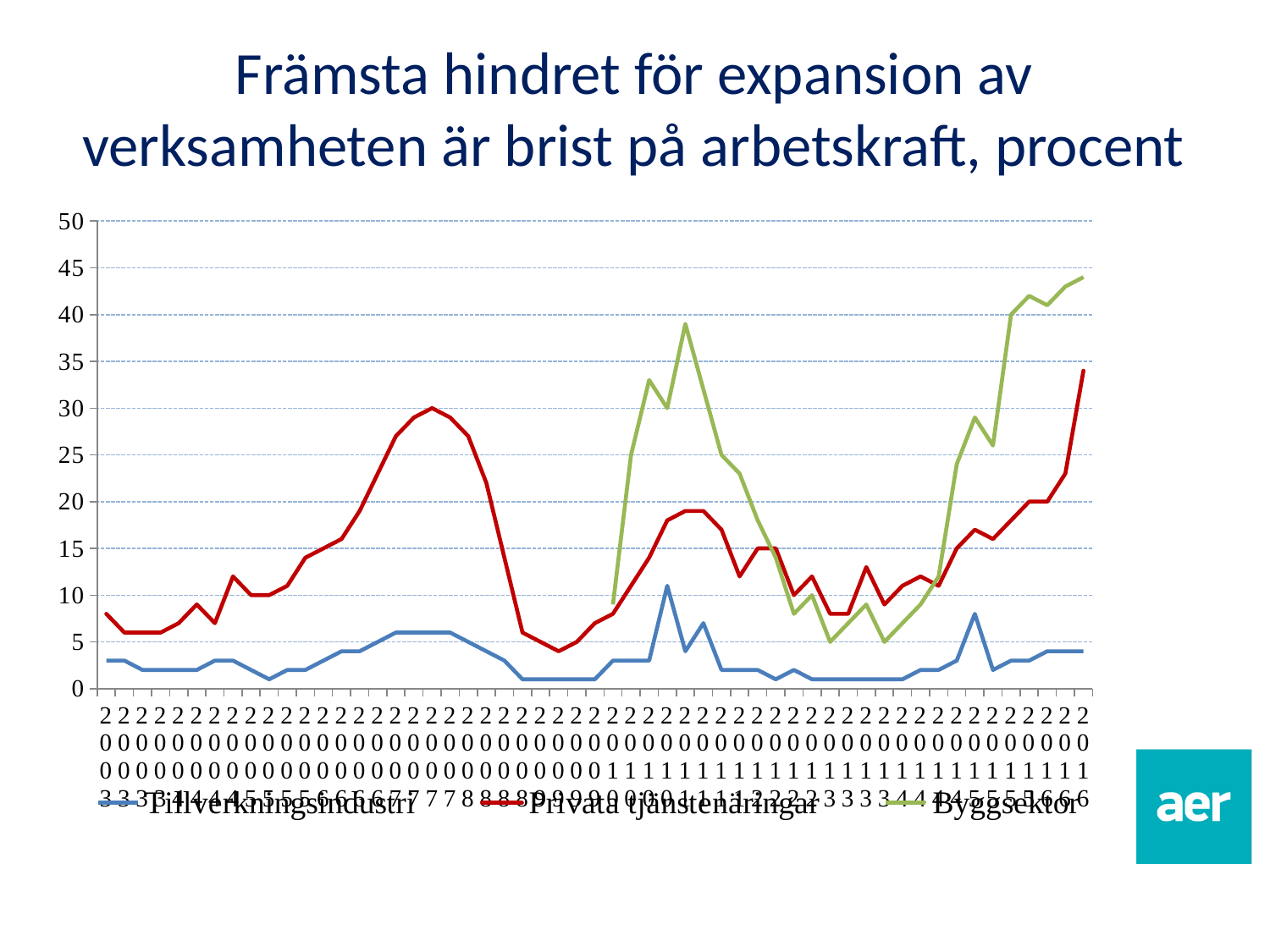
How many series does the legend list? 3 At the right end of the chart, which is higher: Byggsektor or Privata tjänstenäringar? Byggsektor Does the Privata tjänstenäringar line rise or fall between its peak around 2007 and 2009? fall Is the highest value of the Tillverkningsindustri line greater or less than 15? less Does the Byggsektor line rise or fall over the last few points of the chart? rise Is the highest value of the Byggsektor line greater or less than 40? greater What is the title of the chart? Främsta hindret för expansion av verksamheten är brist på arbetskraft, procent Is the final value of the Privata tjänstenäringar line greater or less than 30? greater Which series is drawn in green? Byggsektor What kind of chart is shown on the slide? line chart Which series reaches the highest value anywhere on the chart? Byggsektor Which series stays lowest across the whole chart? Tillverkningsindustri